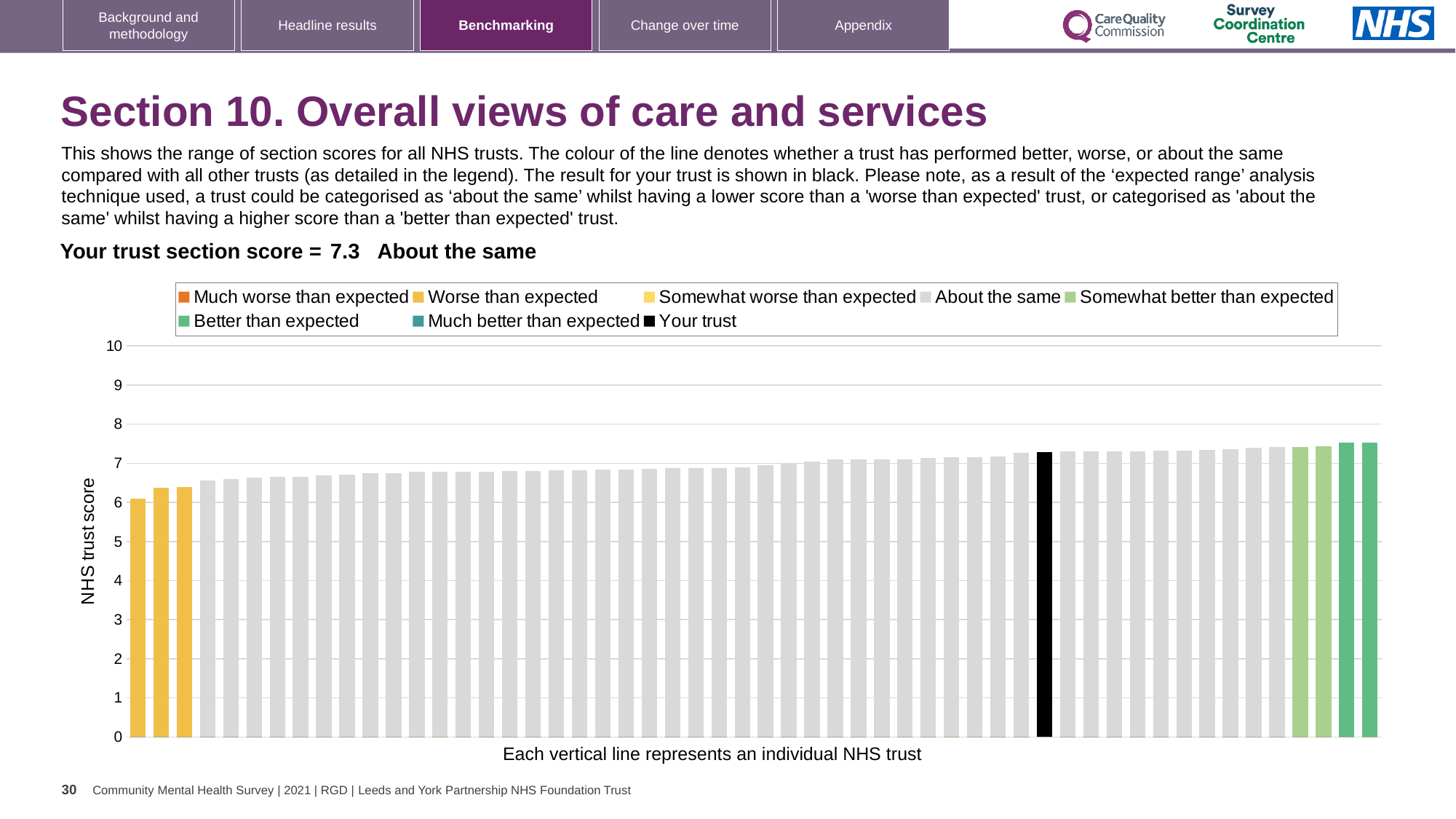
What is the label on the y axis of the chart? NHS trust score Which legend category do the tallest bars on the chart belong to? Better than expected How many bars are coloured as 'Worse than expected'? 3 What type of chart is shown on the slide? bar chart What is the section score for your trust shown on the slide? 7.3 Is the value of the leftmost bar greater or less than 7? less Which legend category do the shortest bars on the chart belong to? Worse than expected Do the bar values rise or fall from left to right along the x axis? rise Is the value of the rightmost bar greater or less than 8? less Which is higher, the black bar for your trust or the leftmost bar? the black bar for your trust Is the value for your trust (the black bar) greater or less than 7? greater How many entries does the chart legend list? 8